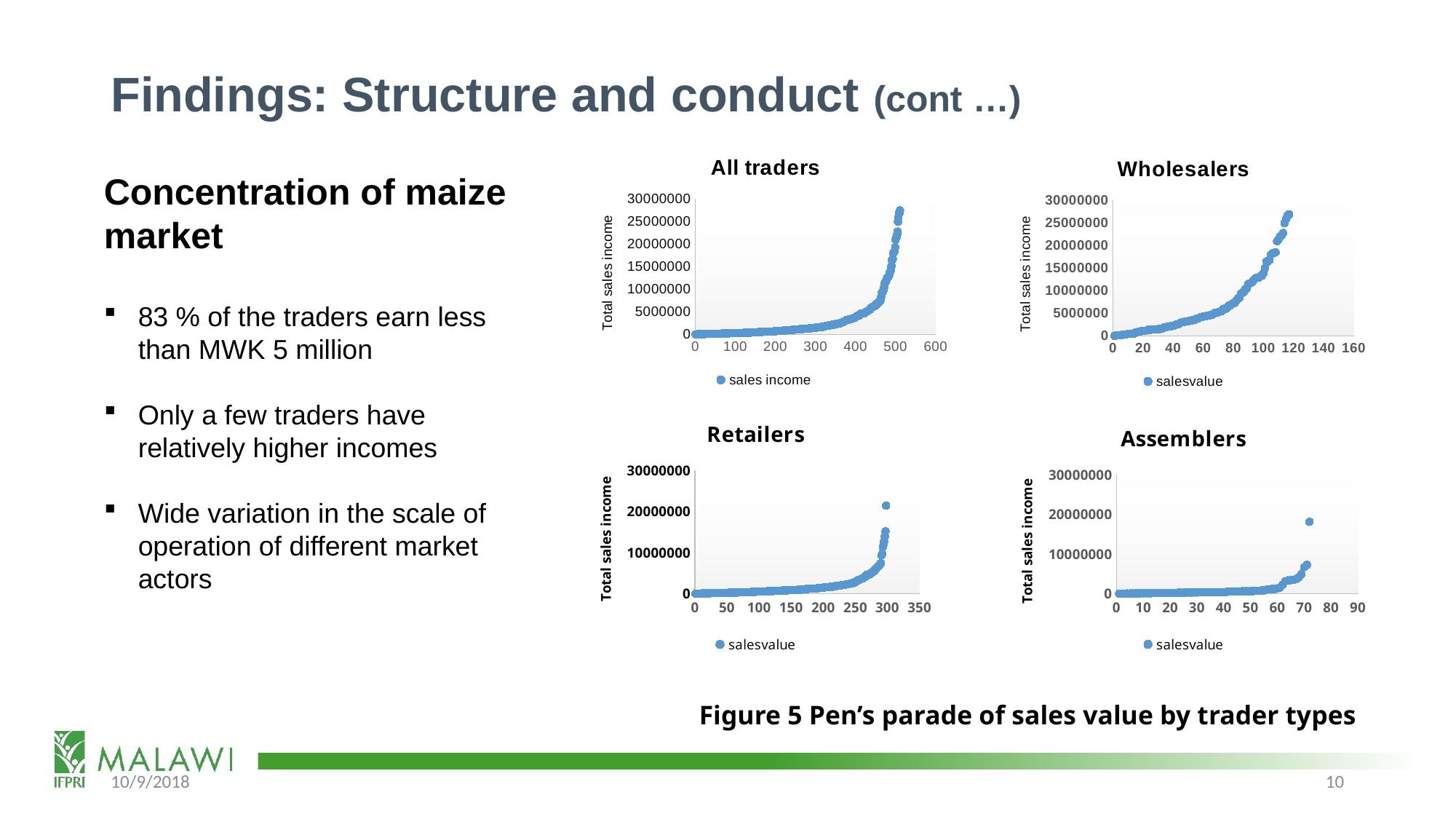
Which chart has the larger maximum plotted value, 'Wholesalers' or 'Assemblers'? Wholesalers In the 'Wholesalers' chart, do the plotted values rise or fall along the x axis? rise How many charts are shown on the slide? 4 What is the y-axis label of the 'Retailers' chart? Total sales income In the 'Wholesalers' chart, is the highest plotted value greater or less than 20000000? greater How many series does the legend of the 'Wholesalers' chart list? 1 In the 'Assemblers' chart, do the plotted values rise or fall along the x axis? rise In the 'Retailers' chart, is the highest plotted value greater or less than 30000000? less What kind of chart is the 'All traders' chart? scatter chart In the 'All traders' chart, is the highest plotted value greater or less than 30000000? less What is the legend entry shown under the 'All traders' chart? sales income